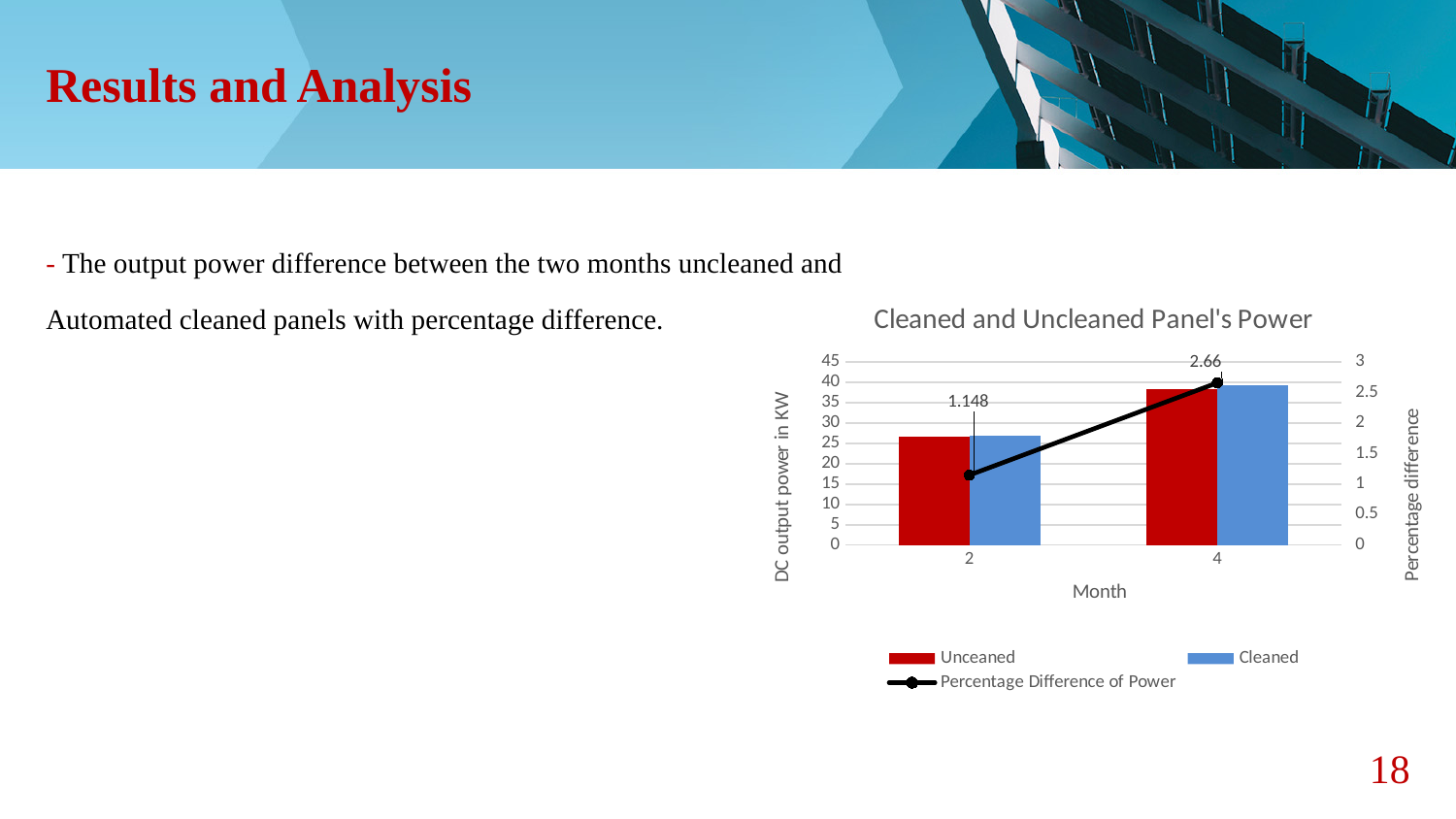
Does the Percentage Difference of Power rise or fall from month 2 to month 4? rise What is the label of the right-hand vertical axis of the chart? Percentage difference What is the value of the Percentage Difference of Power line at month 4? 2.66 Which month has the higher Cleaned DC output power, month 2 or month 4? 4 How many series does the chart legend list? 3 Is the Unceaned DC output power at month 4 greater or less than 40 KW? less Is the Cleaned DC output power at month 4 greater or less than 35 KW? greater What is the value of the Percentage Difference of Power line at month 2? 1.148 What is the title of the chart? Cleaned and Uncleaned Panel's Power Is the Unceaned DC output power at month 2 greater or less than 30 KW? less How many months are shown on the x axis of the chart? 2 What kind of chart is shown on the slide? Combined bar and line chart